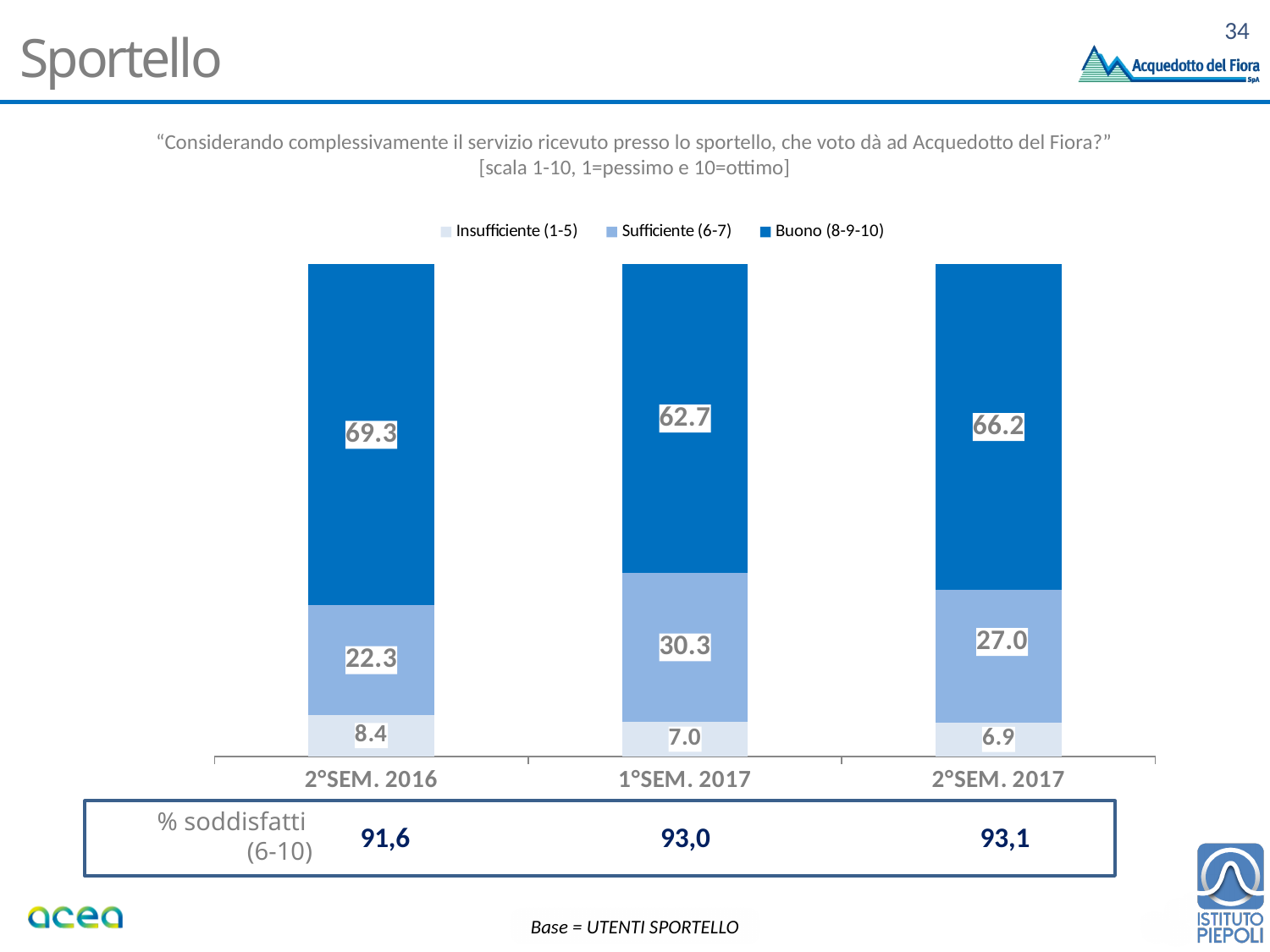
Which period has the highest value for Buono (8-9-10)? 2°SEM. 2016 Which series is shown in the darkest blue? Buono (8-9-10) How many periods are shown on the x axis? 3 How many series does the legend list? 3 What is the value of Buono (8-9-10) for 2°SEM. 2016? 69.3 What kind of chart is shown? Stacked bar chart Which period has the lowest value for Insufficiente (1-5)? 2°SEM. 2017 What is the value of Sufficiente (6-7) for 1°SEM. 2017? 30.3 What is the difference between the Buono (8-9-10) values for 2°SEM. 2016 and 1°SEM. 2017? 6.6 What is the total of the stacked bar for 1°SEM. 2017? 100.0 What is the value of Insufficiente (1-5) for 2°SEM. 2017? 6.9 Which is larger: Sufficiente (6-7) for 1°SEM. 2017 or for 2°SEM. 2017? 1°SEM. 2017